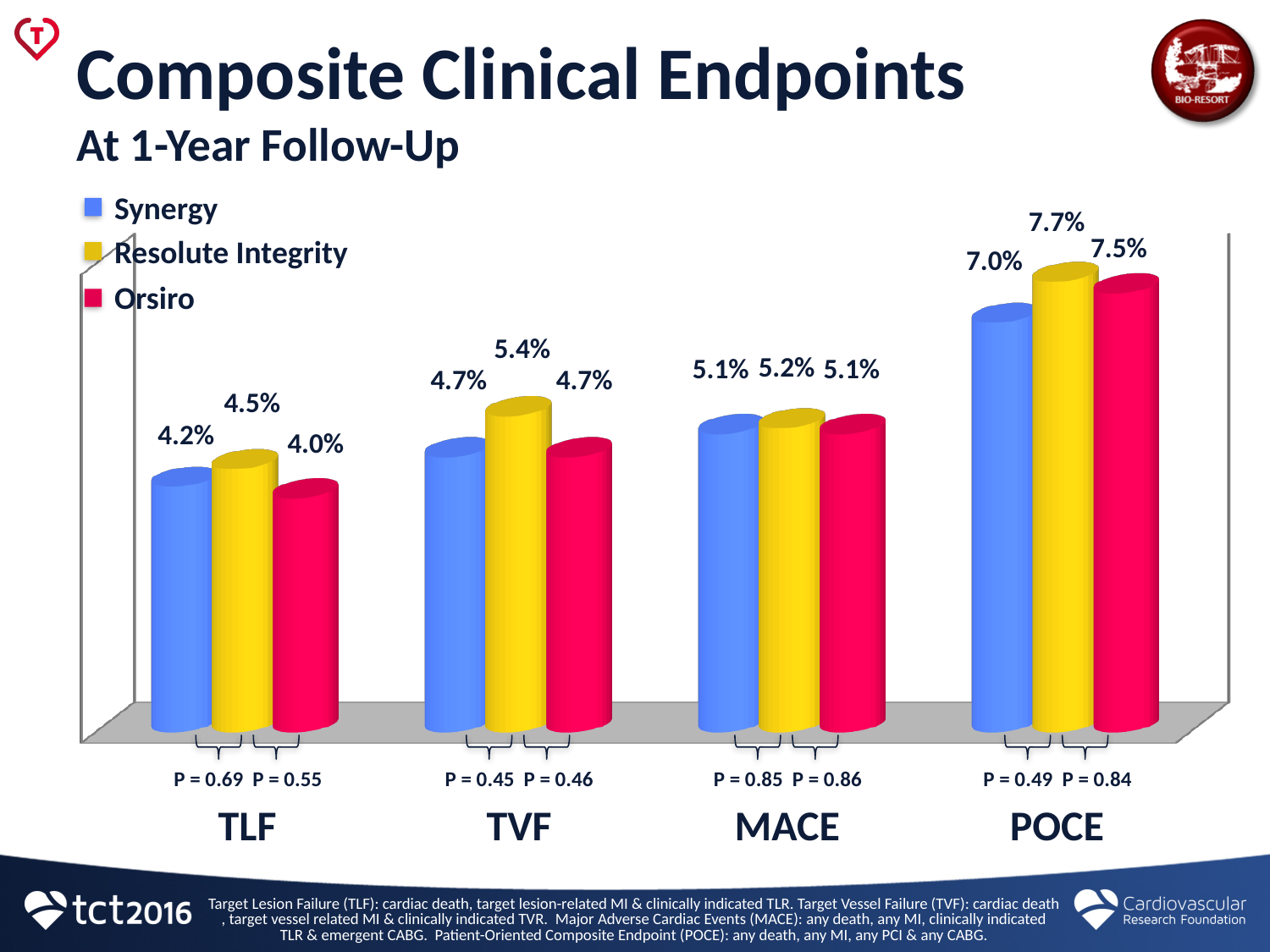
Which is larger in the TLF category, the Synergy value or the Orsiro value? Synergy What kind of chart is shown on the slide? Bar chart How many categories are shown on the x axis? 4 Which category has the lowest value for Orsiro? TLF Which category has the highest value for Synergy? POCE What is the value for Orsiro in the POCE category? 7.5% What is the difference between the Resolute Integrity and Synergy values in the POCE category? 0.7% Which series is shown in red in the legend? Orsiro What is the value for Synergy in the TLF category? 4.2% How many series does the legend list? 3 What is the value for Resolute Integrity in the TVF category? 5.4% What is the value for Resolute Integrity in the MACE category? 5.2%